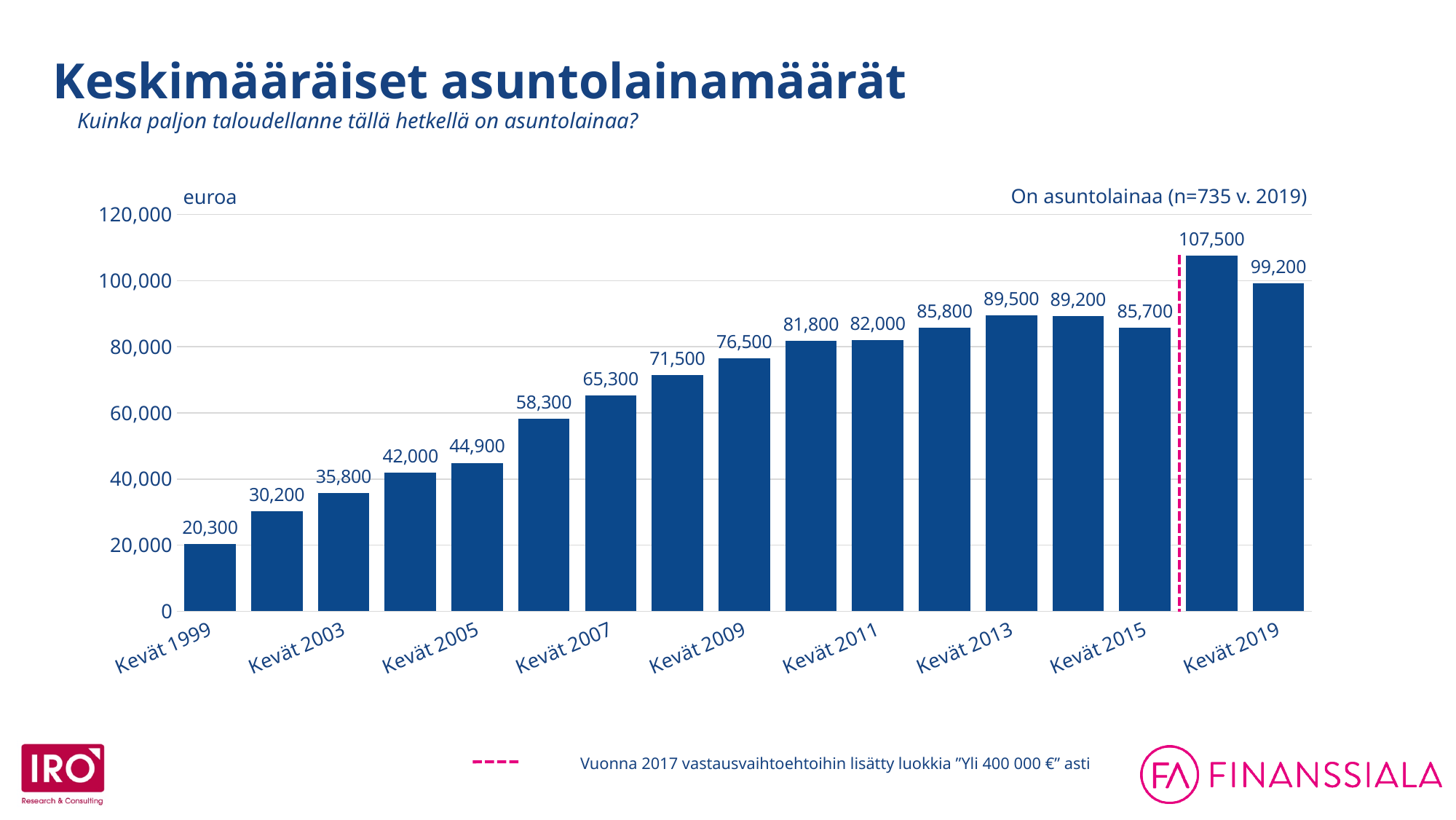
Which is larger, the value for Kevät 2013 or the value for Kevät 2015? Kevät 2013 What is the average housing loan amount shown for Kevät 1999? 20,300 Which labelled year has the lowest value? Kevät 1999 What unit is indicated at the top of the vertical axis? euroa What value is shown for Kevät 2019? 99,200 What is the highest value shown on any bar in the chart? 107,500 What type of chart is shown on the slide? bar chart What value is shown for Kevät 2011? 82,000 What value is shown for Kevät 2007? 65,300 Is the value for Kevät 2009 greater or less than 80,000? less What is the difference between the values for Kevät 2019 and Kevät 1999? 78,900 How many bars are in the chart? 17